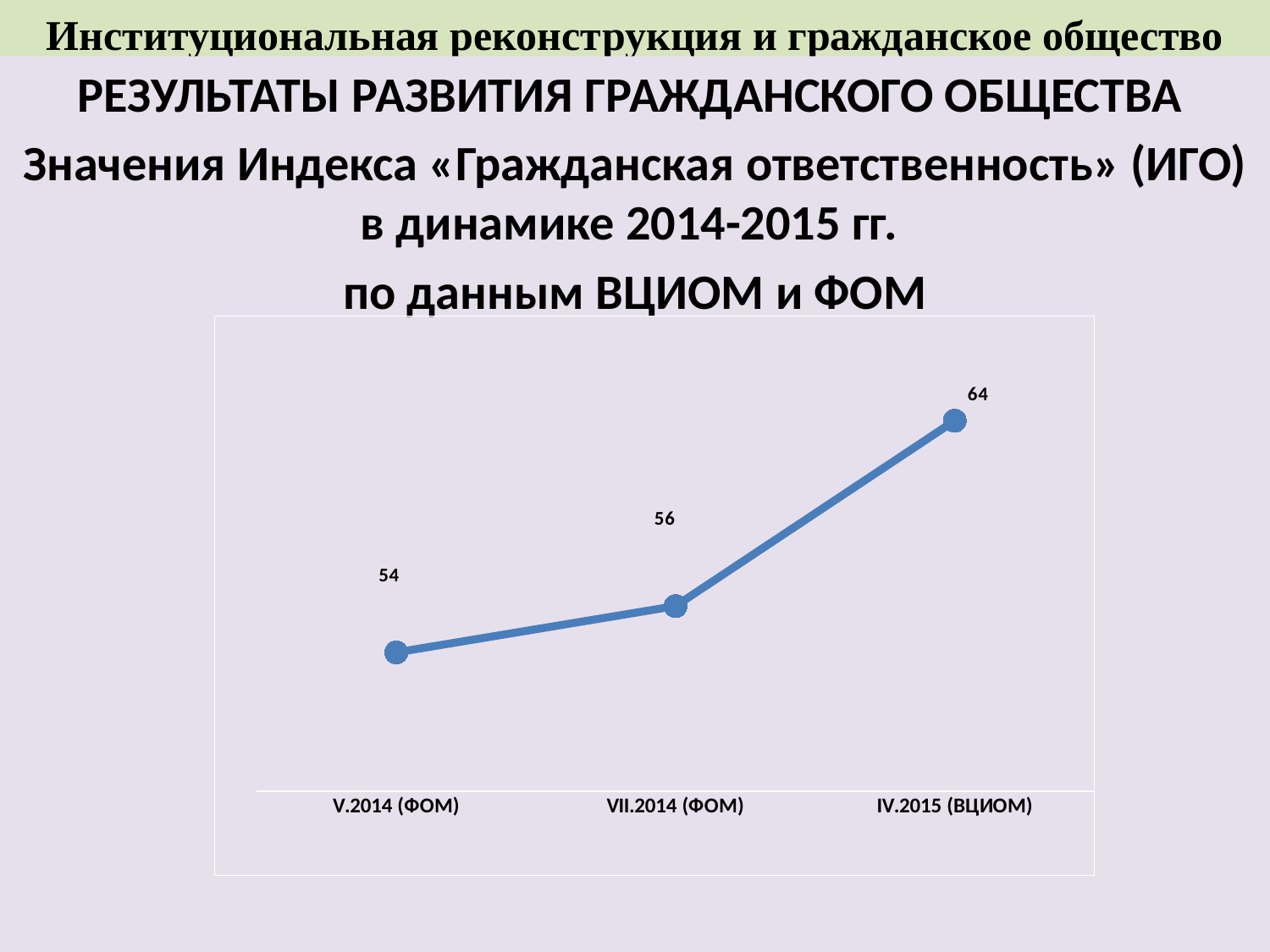
Do the values rise or fall from V.2014 (ФОМ) to IV.2015 (ВЦИОМ)? rise How many data points are plotted on the chart? 3 Which point has the lowest value? V.2014 (ФОМ) What kind of chart is shown on the slide? line chart What is the label of the last category on the x axis? IV.2015 (ВЦИОМ) What is the difference between the values for IV.2015 (ВЦИОМ) and V.2014 (ФОМ)? 10 What is the value for VII.2014 (ФОМ)? 56 Which is larger, the value for VII.2014 (ФОМ) or the value for IV.2015 (ВЦИОМ)? IV.2015 (ВЦИОМ) Which point has the highest value? IV.2015 (ВЦИОМ) What is the difference between the values for VII.2014 (ФОМ) and V.2014 (ФОМ)? 2 What is the value for IV.2015 (ВЦИОМ)? 64 What is the value for V.2014 (ФОМ)? 54